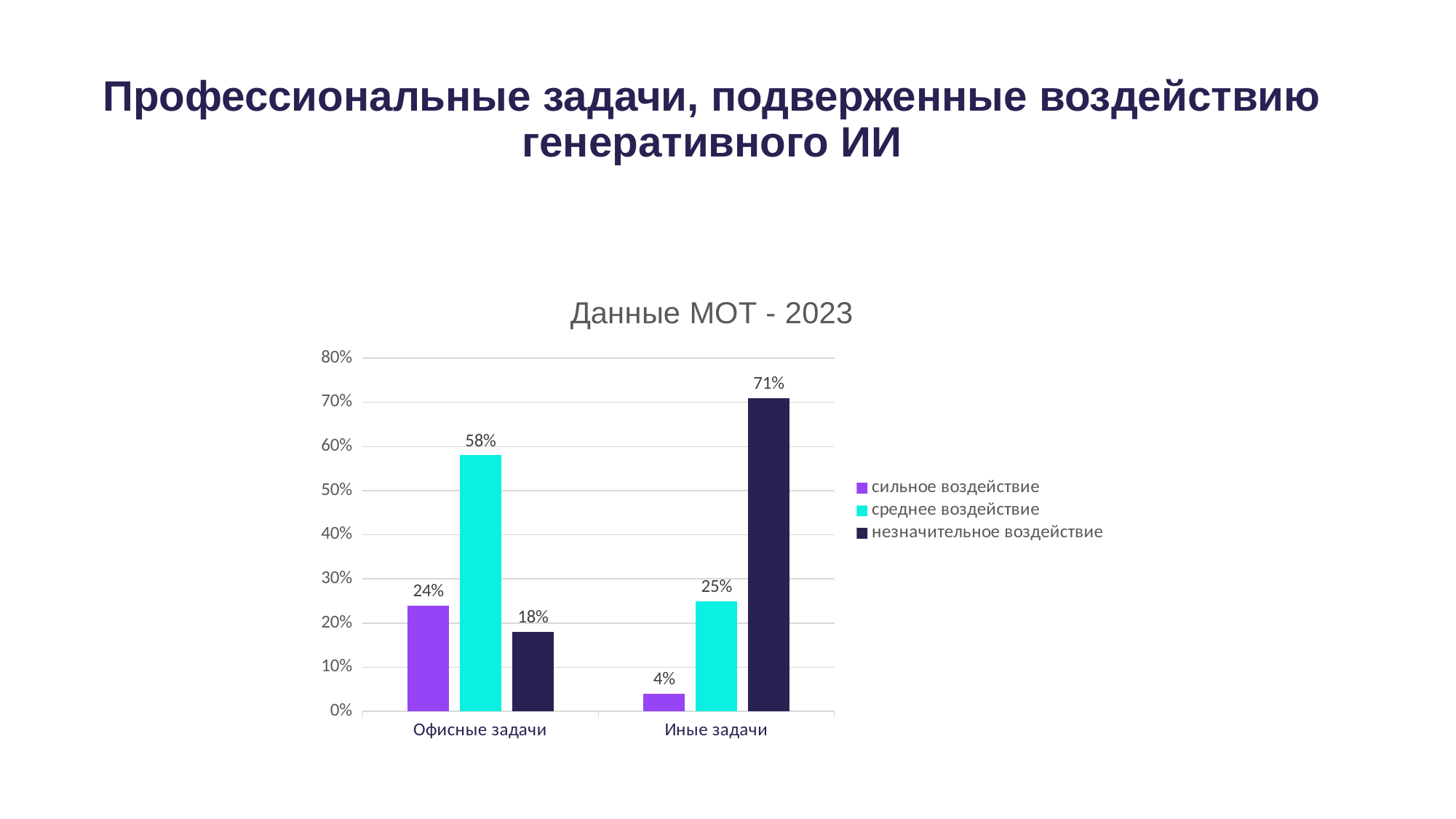
What is the value for 'среднее воздействие' in the 'Офисные задачи' category? 58% How many categories are shown on the x axis? 2 What is the difference between the 'незначительное воздействие' values for 'Иные задачи' and 'Офисные задачи'? 53% Which series has the lowest value in the 'Офисные задачи' category? незначительное воздействие What is the title of the chart? Данные МОТ - 2023 What kind of chart is shown on the slide? bar chart Which is larger: 'сильное воздействие' for 'Офисные задачи' or 'сильное воздействие' for 'Иные задачи'? Офисные задачи Is the value for 'среднее воздействие' in 'Иные задачи' greater or less than 30%? less Which series has the highest value in the 'Иные задачи' category? незначительное воздействие How many series does the legend list? 3 What is the value for 'незначительное воздействие' in the 'Иные задачи' category? 71% What is the value for 'сильное воздействие' in the 'Офисные задачи' category? 24%